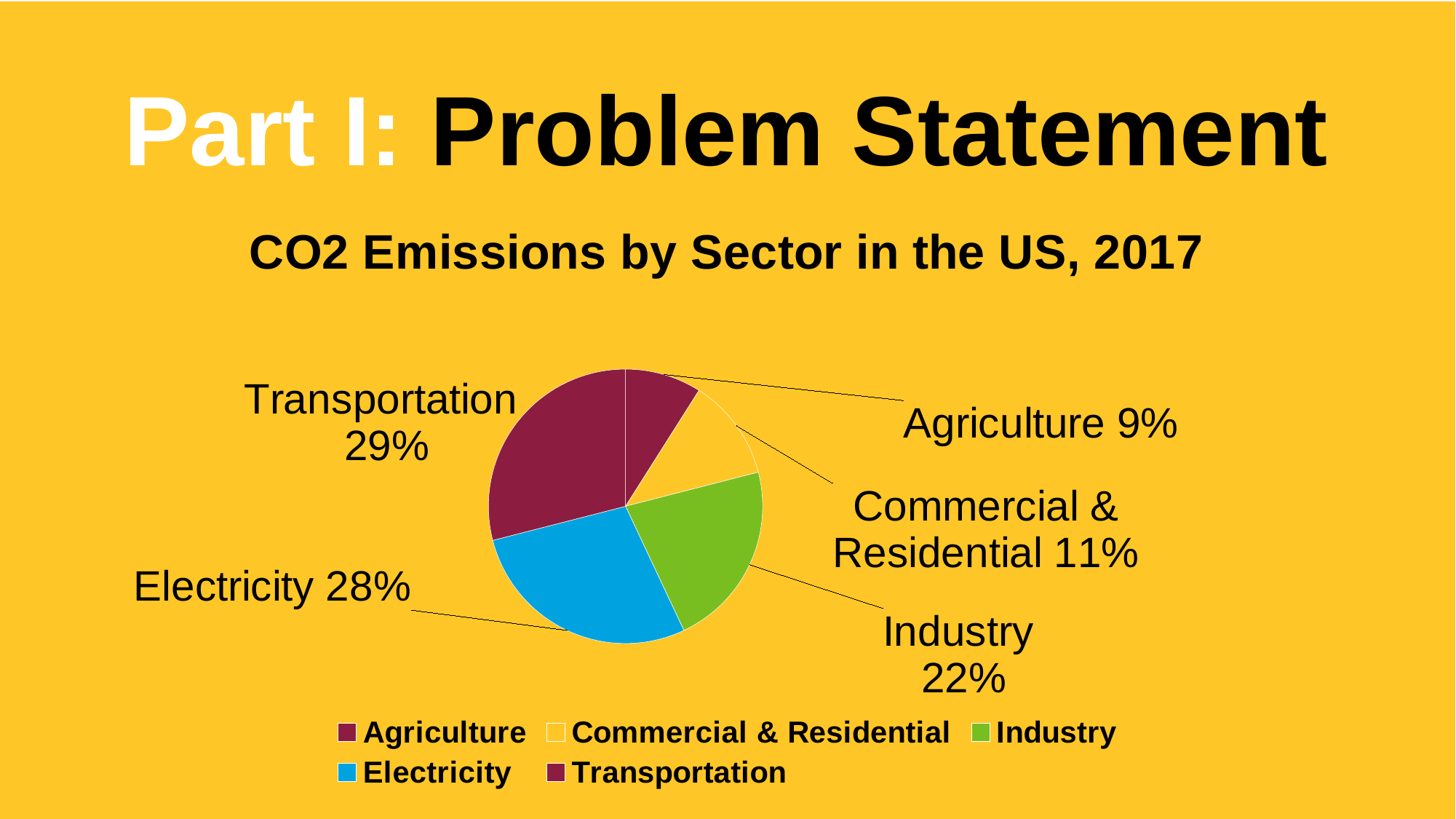
What kind of chart is shown on the slide? Pie chart What is the difference in percentage points between Electricity and Industry? 6 Which sector has the largest share of CO2 emissions? Transportation What share of CO2 emissions does Agriculture account for? 9% What share of CO2 emissions does Transportation account for? 29% What share of CO2 emissions does Commercial & Residential account for? 11% What is the title of the chart? CO2 Emissions by Sector in the US, 2017 How many sectors are shown in the pie chart? 5 Which sector has the smallest share of CO2 emissions? Agriculture What share of CO2 emissions does Industry account for? 22% Which has a larger share, Industry or Commercial & Residential? Industry What colour is the Electricity slice? Blue